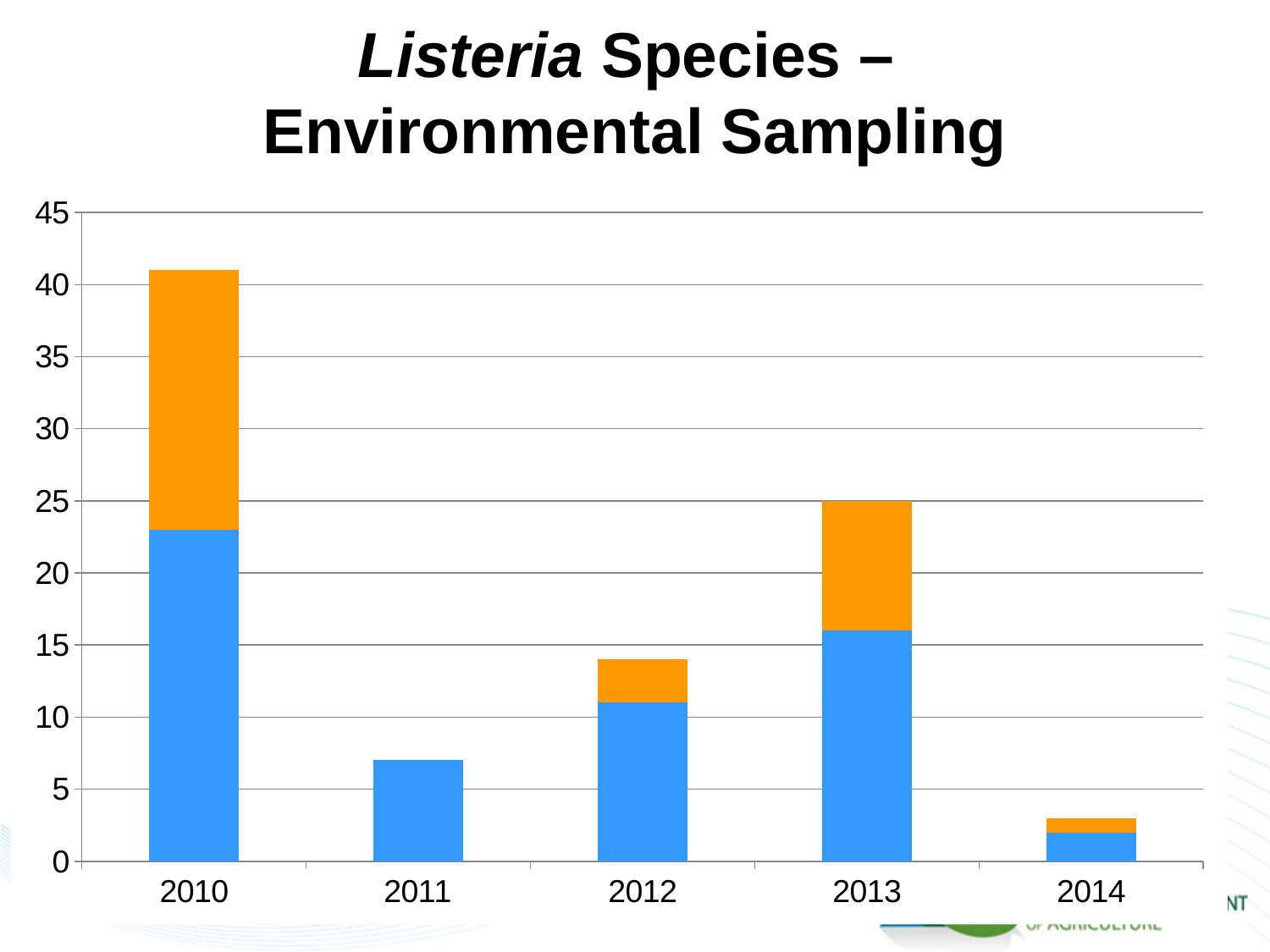
Which year has the tallest bar in the chart? 2010 Is the total bar height for 2014 greater or less than 5? less What kind of chart is shown on the slide? bar chart Is the bar height for 2011 greater or less than 10? less Which year has the shortest bar in the chart? 2014 Which year has the taller bar, 2010 or 2013? 2010 Is the total bar height for 2010 greater or less than 40? greater What is the title of the slide containing the chart? Listeria Species – Environmental Sampling Does the total bar height rise or fall from 2010 to 2011? fall How many years are shown on the x axis of the chart? 5 Which year has the taller bar, 2011 or 2012? 2012